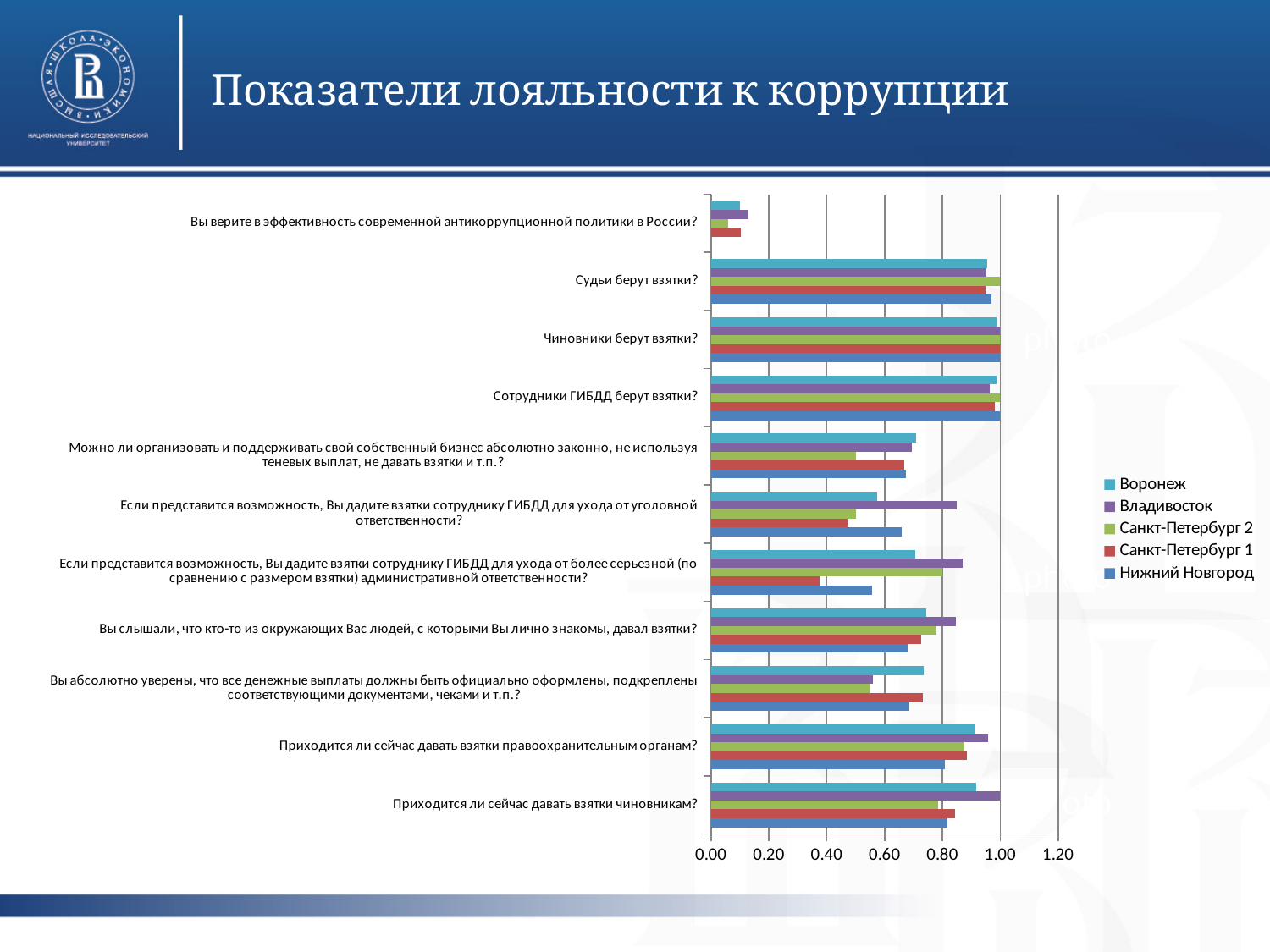
How many question categories are plotted on the chart? 11 Is the value for Санкт-Петербург 1 on "Если представится возможность, Вы дадите взятки сотруднику ГИБДД для ухода от более серьезной (по сравнению с размером взятки) административной ответственности?" greater or less than 0.60? less What kind of chart is shown on the slide? Bar chart Is the value for Нижний Новгород on "Судьи берут взятки?" greater or less than 0.80? greater Is the value for Воронеж on "Вы верите в эффективность современной антикоррупционной политики в России?" greater or less than 0.20? less Which series is listed first in the legend? Воронеж For "Если представится возможность, Вы дадите взятки сотруднику ГИБДД для ухода от более серьезной (по сравнению с размером взятки) административной ответственности?", which is larger: Владивосток or Санкт-Петербург 1? Владивосток Which category has the lowest values across all series? Вы верите в эффективность современной антикоррупционной политики в России? What is the title of the slide containing the chart? Показатели лояльности к коррупции For "Вы абсолютно уверены, что все денежные выплаты должны быть официально оформлены, подкреплены соответствующими документами, чеками и т.п.?", which is larger: Санкт-Петербург 1 or Санкт-Петербург 2? Санкт-Петербург 1 How many series does the legend list? 5